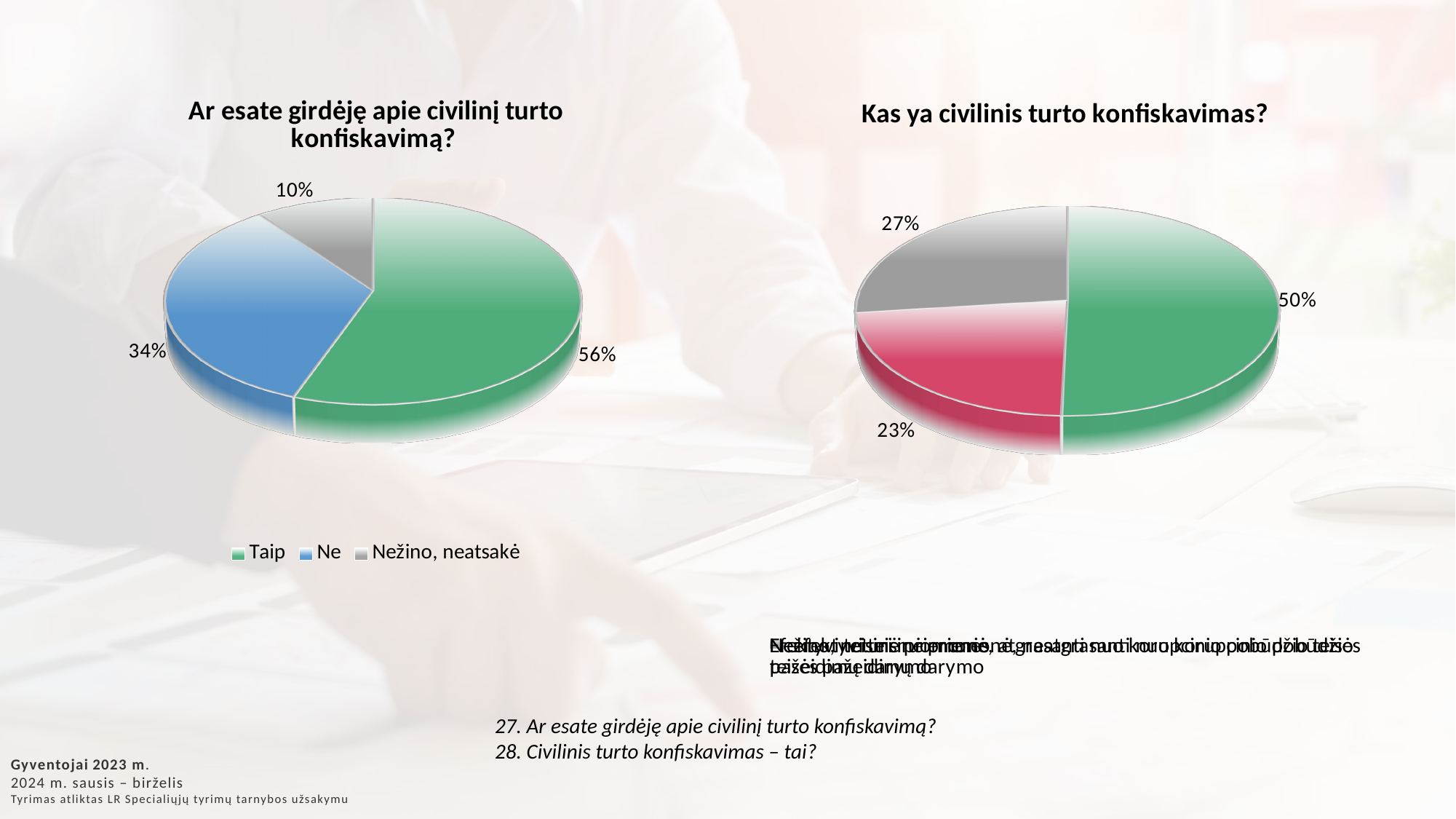
In the chart titled "Ar esate girdėję apie civilinį turto konfiskavimą?", what share is labelled "Nežino, neatsakė"? 10% In the chart titled "Ar esate girdėję apie civilinį turto konfiskavimą?", how many percentage points larger is "Taip" than "Ne"? 22 percentage points What type of chart is the one titled "Ar esate girdėję apie civilinį turto konfiskavimą?"? Pie chart In the chart titled "Kas ya civilinis turto konfiskavimas?", how many slices does the pie have? 3 In the chart titled "Kas ya civilinis turto konfiskavimas?", what is the smallest slice's share? 23% In the chart titled "Kas ya civilinis turto konfiskavimas?", what share does the grey slice represent? 27% In the chart titled "Ar esate girdėję apie civilinį turto konfiskavimą?", what share of respondents answered "Taip"? 56% In the chart titled "Ar esate girdėję apie civilinį turto konfiskavimą?", which answer has the largest share? Taip In the chart titled "Ar esate girdėję apie civilinį turto konfiskavimą?", what share of respondents answered "Ne"? 34% In the chart titled "Ar esate girdėję apie civilinį turto konfiskavimą?", which answer has the smallest share? Nežino, neatsakė In the chart titled "Ar esate girdėję apie civilinį turto konfiskavimą?", how many entries does the legend list? 3 In the chart titled "Kas ya civilinis turto konfiskavimas?", what is the largest slice's share? 50%